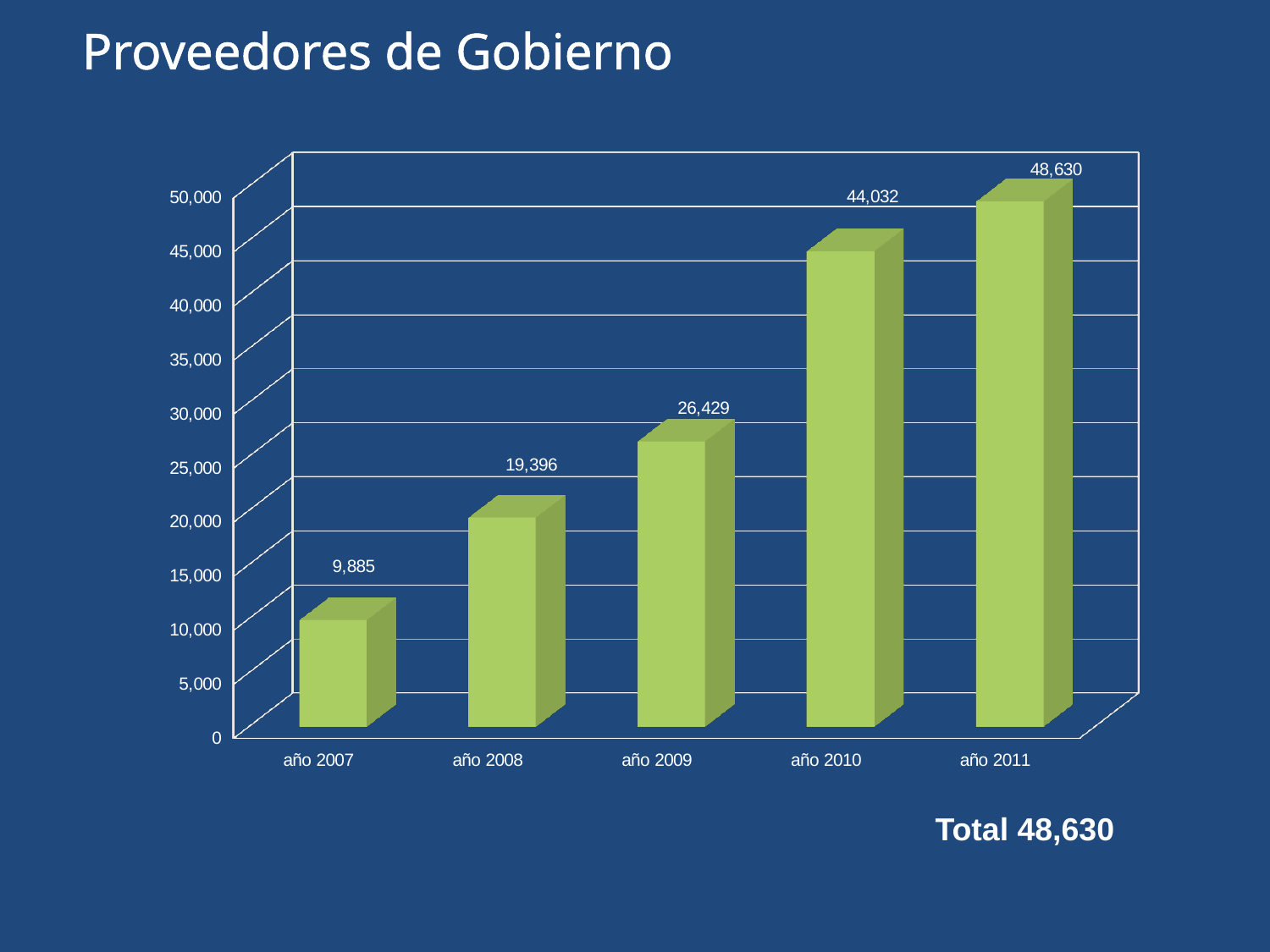
What is the difference between the values for año 2008 and año 2007? 9,511 Is the value for año 2008 greater or less than 15,000? greater What kind of chart is shown on the slide? bar chart Which is larger, the value for año 2009 or the value for año 2010? año 2010 What is the value for año 2009? 26,429 What is the value for año 2007? 9,885 What is the difference between the values for año 2011 and año 2010? 4,598 What is the value for año 2011? 48,630 Do the values rise or fall from año 2007 to año 2011? rise How many years are shown on the x axis? 5 Which year has the lowest value? año 2007 Which year has the highest value? año 2011